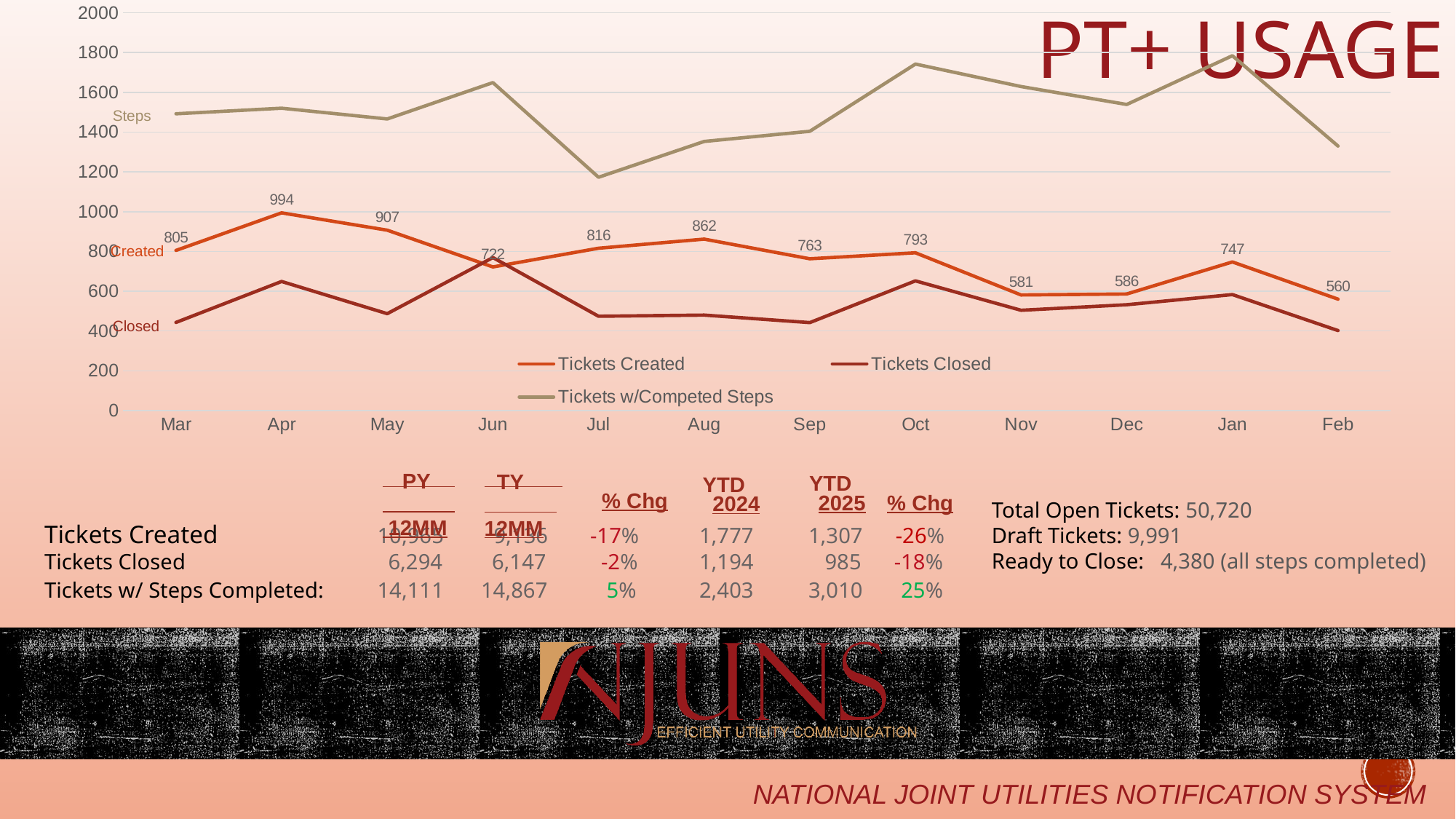
Is the value for Tickets w/Competed Steps in Oct greater or less than 1600? greater Is the value for Tickets Closed in Jun greater or less than 600? greater What is the value of Tickets Created in Sep? 763 In which month is Tickets Created highest? Apr Does Tickets Created rise or fall from Oct to Nov? fall How many months are plotted along the x axis of the chart? 12 In which month is Tickets Created lowest? Feb How many series does the chart legend list? 3 What type of chart is shown on the slide? line chart What is the difference between Tickets Created in Apr and in Jun? 272 What is the value of Tickets Created in Apr? 994 Which is larger, Tickets Created in Aug or Tickets Created in Jan? Aug